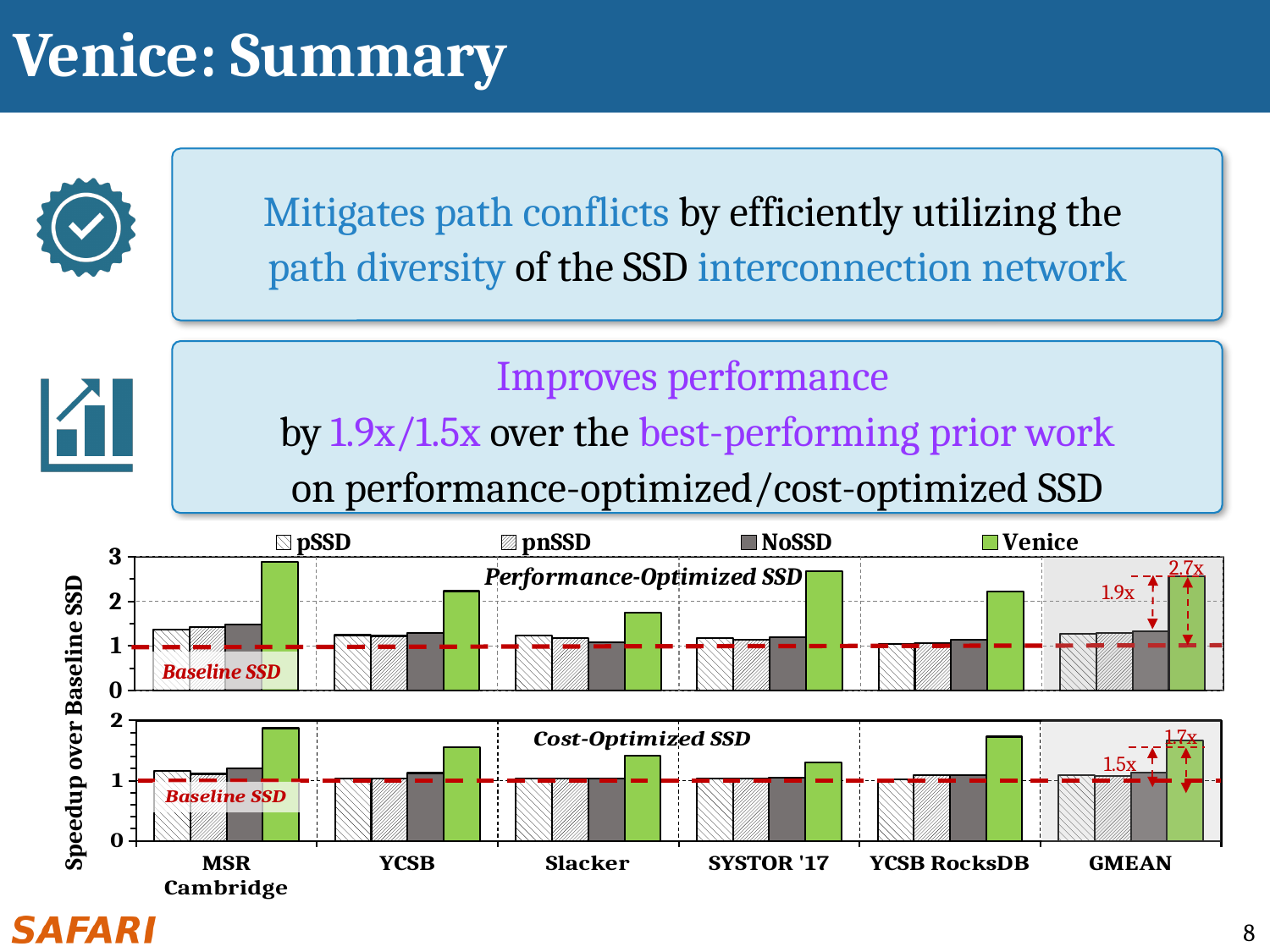
In the Performance-Optimized SSD chart, is the Venice value for MSR Cambridge greater or less than 2? greater In the Performance-Optimized SSD chart, what speedup annotation is shown for Venice over the best prior work at GMEAN? 1.9x In the Cost-Optimized SSD chart, what speedup annotation is shown for Venice over the best prior work at GMEAN? 1.5x In the Cost-Optimized SSD chart, what speedup annotation is shown for Venice over the baseline at GMEAN? 1.7x In the Performance-Optimized SSD chart, what speedup annotation is shown for Venice over the baseline at GMEAN? 2.7x In the Cost-Optimized SSD chart, which is larger for YCSB: the Venice bar or the NoSSD bar? Venice How many series does the legend list for the charts? 4 In the Performance-Optimized SSD chart, which workload has the lowest Venice bar? Slacker How many workload categories are shown along the x axis of the Cost-Optimized SSD chart? 6 In the Performance-Optimized SSD chart, is the Venice value for Slacker greater or less than 2? less In the Cost-Optimized SSD chart, which workload has the highest Venice bar? MSR Cambridge What kind of chart is the Performance-Optimized SSD chart? bar chart